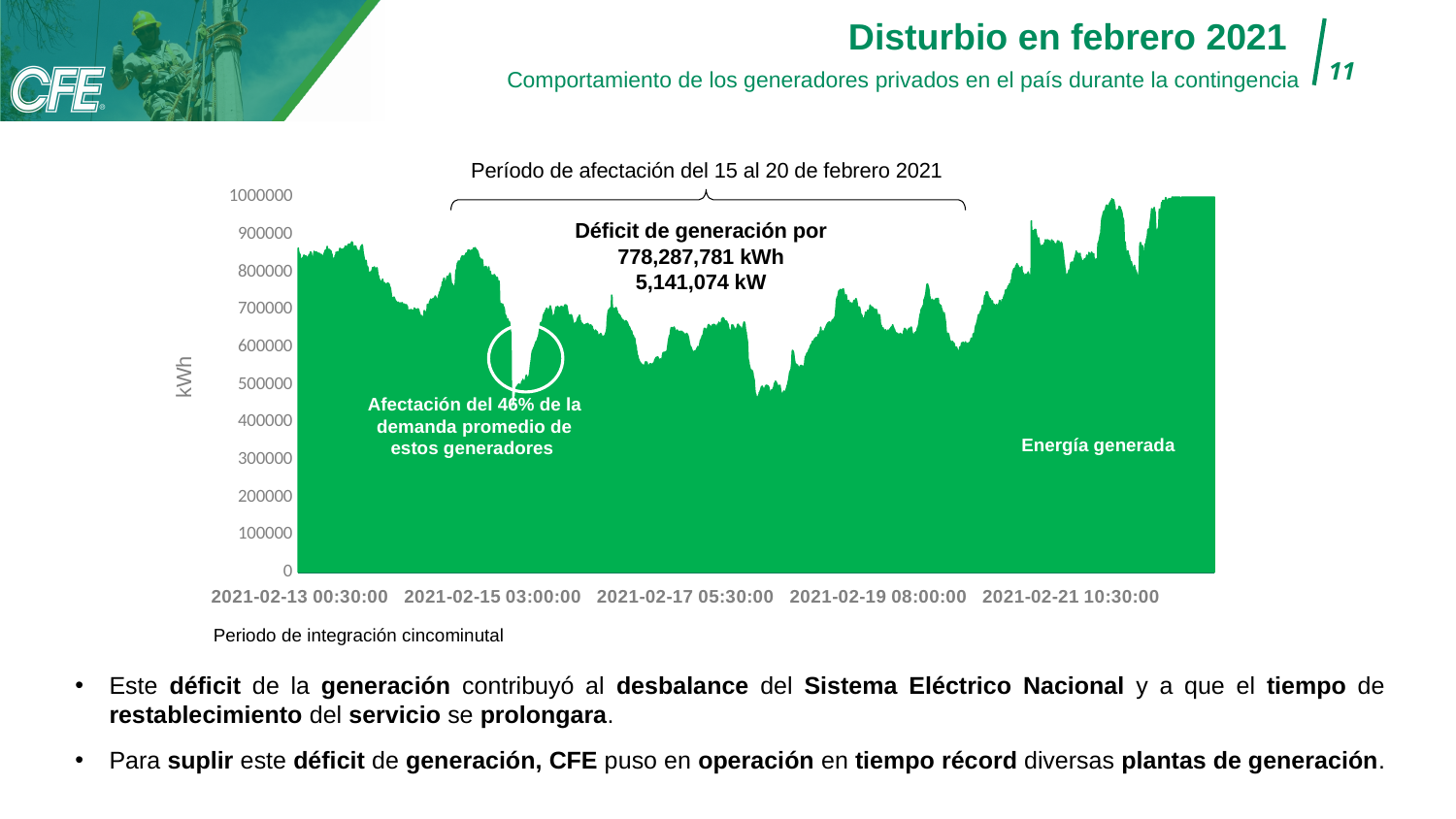
Is the generated energy at the lowest point of the chart, near 2021-02-15, greater or less than 600000 kWh? less How many date-time tick labels are shown on the x-axis of the chart? 5 What is the first date-time label on the x-axis of the chart? 2021-02-13 00:30:00 What is the highest value shown on the y-axis of the chart? 1000000 What is the name of the plotted series labelled on the chart? Energía generada What kind of chart is shown on the slide? Area chart What is the generation deficit in kWh stated on the chart? 778,287,781 kWh What percentage of the average demand of these generators was affected, according to the chart annotation? 46% What unit is shown on the y-axis of the chart? kWh Is the generated energy at the start of the chart (2021-02-13 00:30:00) greater or less than 800000 kWh? greater Is the generated energy at the end of the chart (around 2021-02-21) greater or less than 900000 kWh? greater What is the generation deficit in kW stated on the chart? 5,141,074 kW